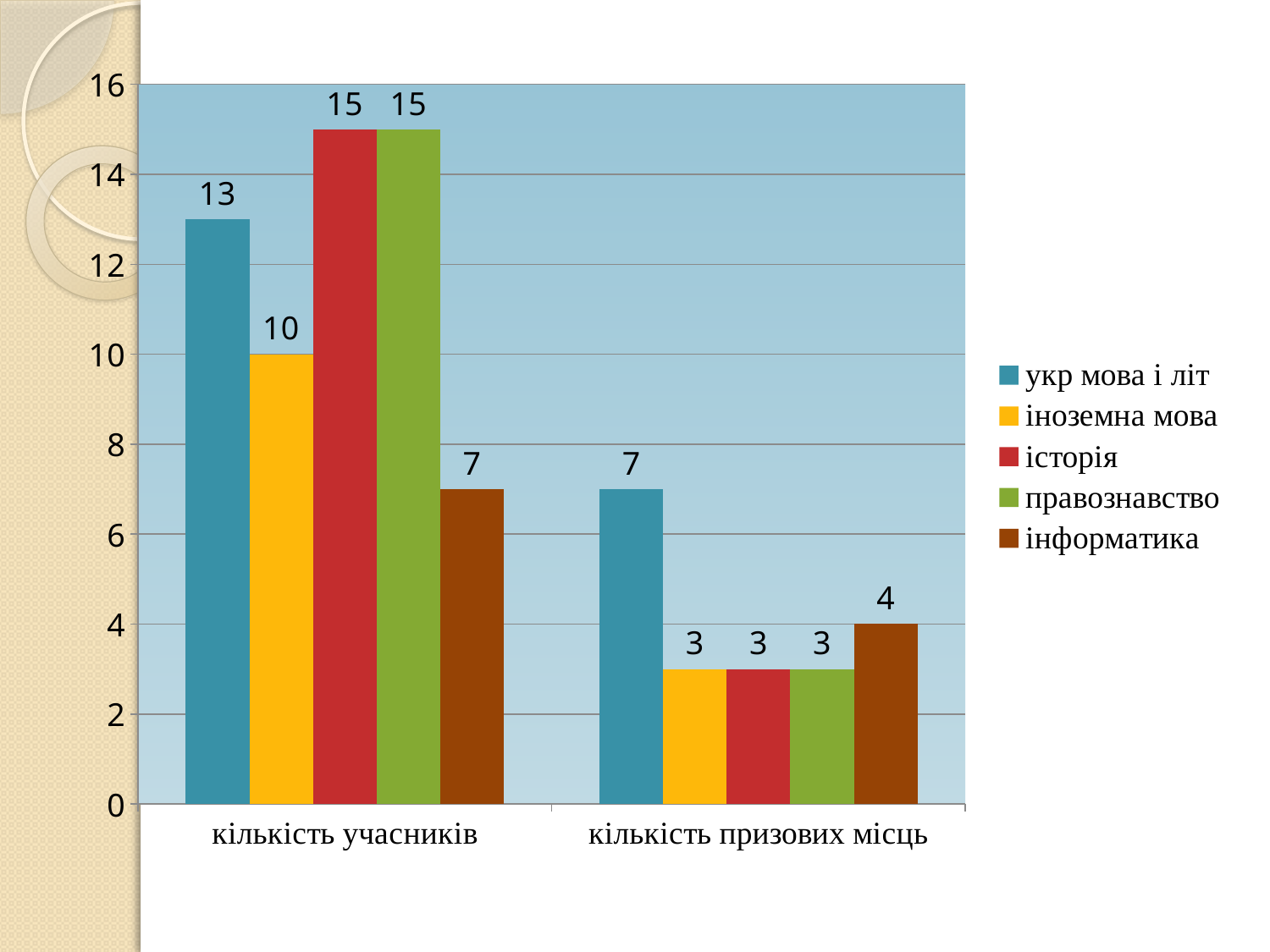
Which series has the lowest value in the кількість учасників category? інформатика What kind of chart is shown on the slide? bar chart Which colour represents правознавство in the legend? green What is the value for укр мова і літ in the кількість учасників category? 13 How many series does the legend list? 5 What is the value for інформатика in the кількість призових місць category? 4 What is the value for іноземна мова in the кількість учасників category? 10 Which is larger in the кількість учасників category: укр мова і літ or іноземна мова? укр мова і літ What is the difference between the укр мова і літ values for кількість учасників and кількість призових місць? 6 Which series has the highest value in the кількість призових місць category? укр мова і літ How many categories are shown on the x axis? 2 What is the difference between the кількість учасників values for історія and інформатика? 8